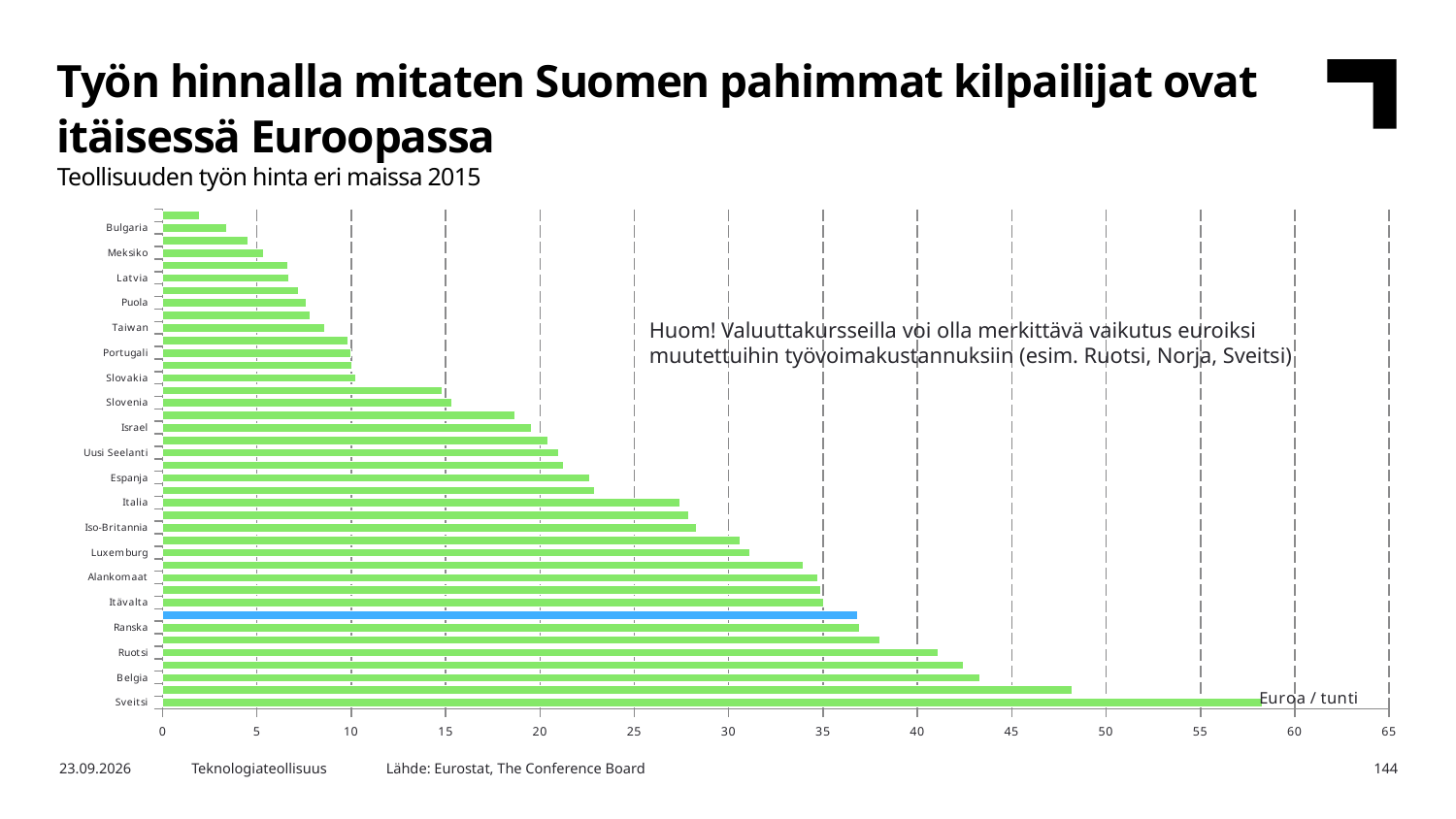
Is the value for Iso-Britannia greater or less than 30? less Is the value for Bulgaria greater or less than 5? less Which labelled country has the highest labour cost in the chart? Sveitsi Is the value for Italia greater or less than 25? greater Are the bars ordered ascending or descending from top to bottom? ascending Which has a higher value, Ranska or Taiwan? Ranska What kind of chart is shown on the slide? bar chart What unit is shown on the chart's horizontal axis? Euroa / tunti Which has a higher value, Sveitsi or Belgia? Sveitsi